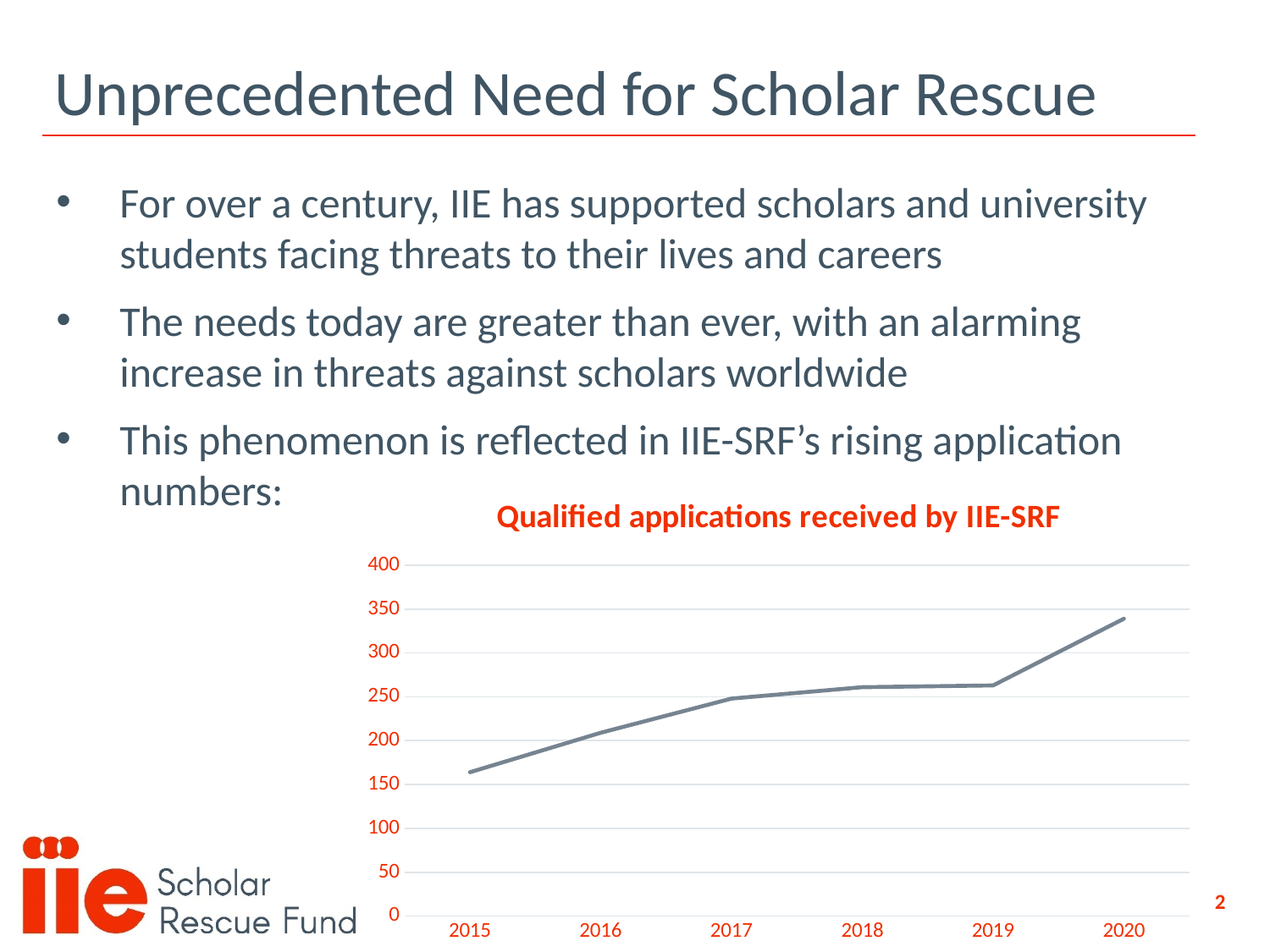
Which year has the lowest number of qualified applications? 2015 Which year has the larger value, 2015 or 2020? 2020 What is the title of the chart? Qualified applications received by IIE-SRF Do the values rise or fall from 2015 to 2020? rise Is the value for 2020 greater or less than 300? greater What kind of chart is shown on the slide? line chart Is the value for 2016 greater or less than 250? less How many years are plotted on the x axis of the chart? 6 Is the value for 2017 greater or less than 200? greater Which year has the highest number of qualified applications? 2020